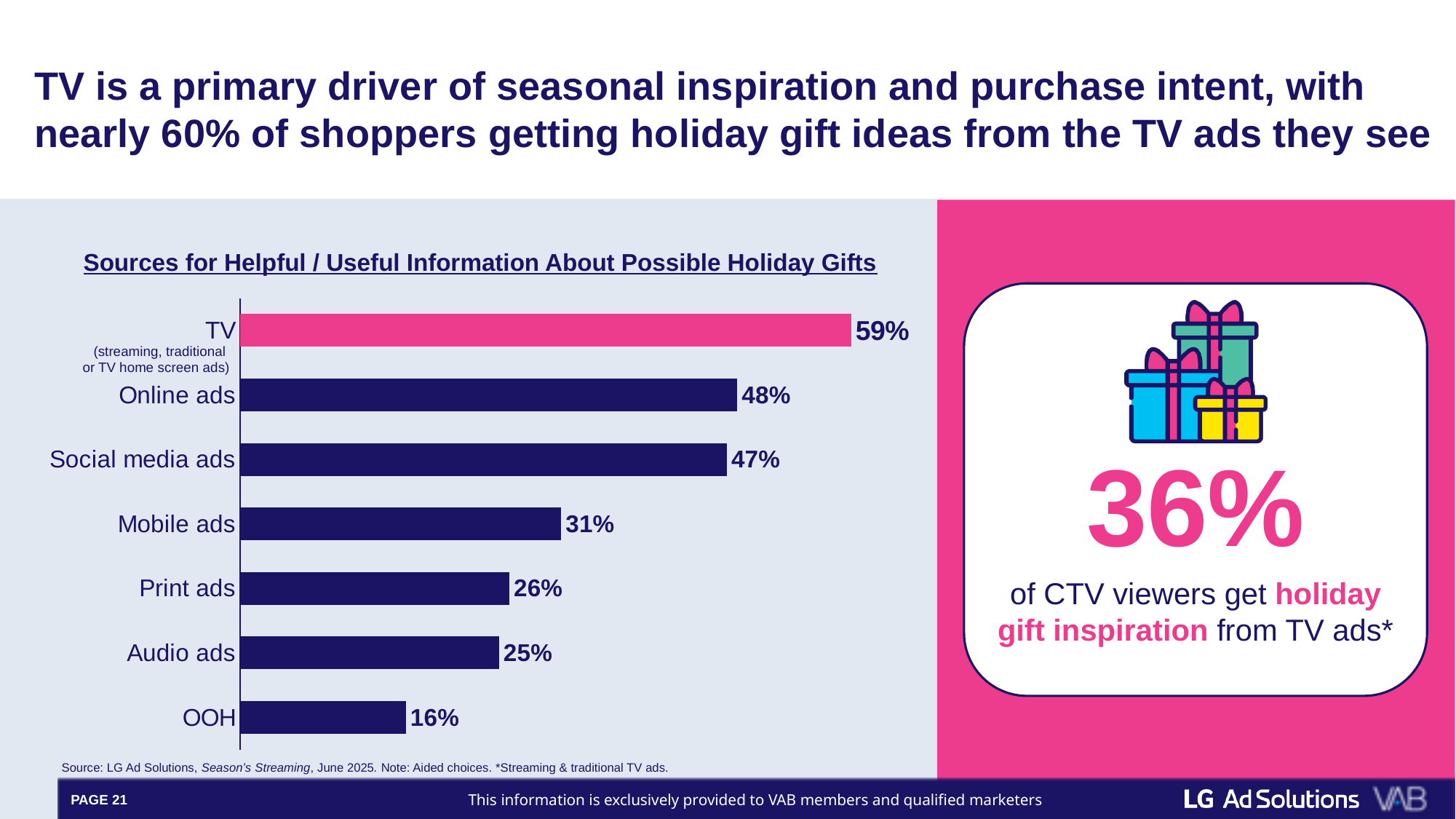
What is the value for Print ads? 26% Which is larger, the value for Mobile ads or the value for Print ads? Mobile ads What is the difference between the values for TV and Online ads? 11% What kind of chart is shown on the slide? Bar chart What is the value for OOH? 16% Which source has the lowest value? OOH What is the value for Social media ads? 47% Which source has the highest value? TV How many sources are shown in the chart? 7 What is the value for TV in the chart? 59% What is the difference between the values for Mobile ads and Audio ads? 6% What is the title of the chart? Sources for Helpful / Useful Information About Possible Holiday Gifts